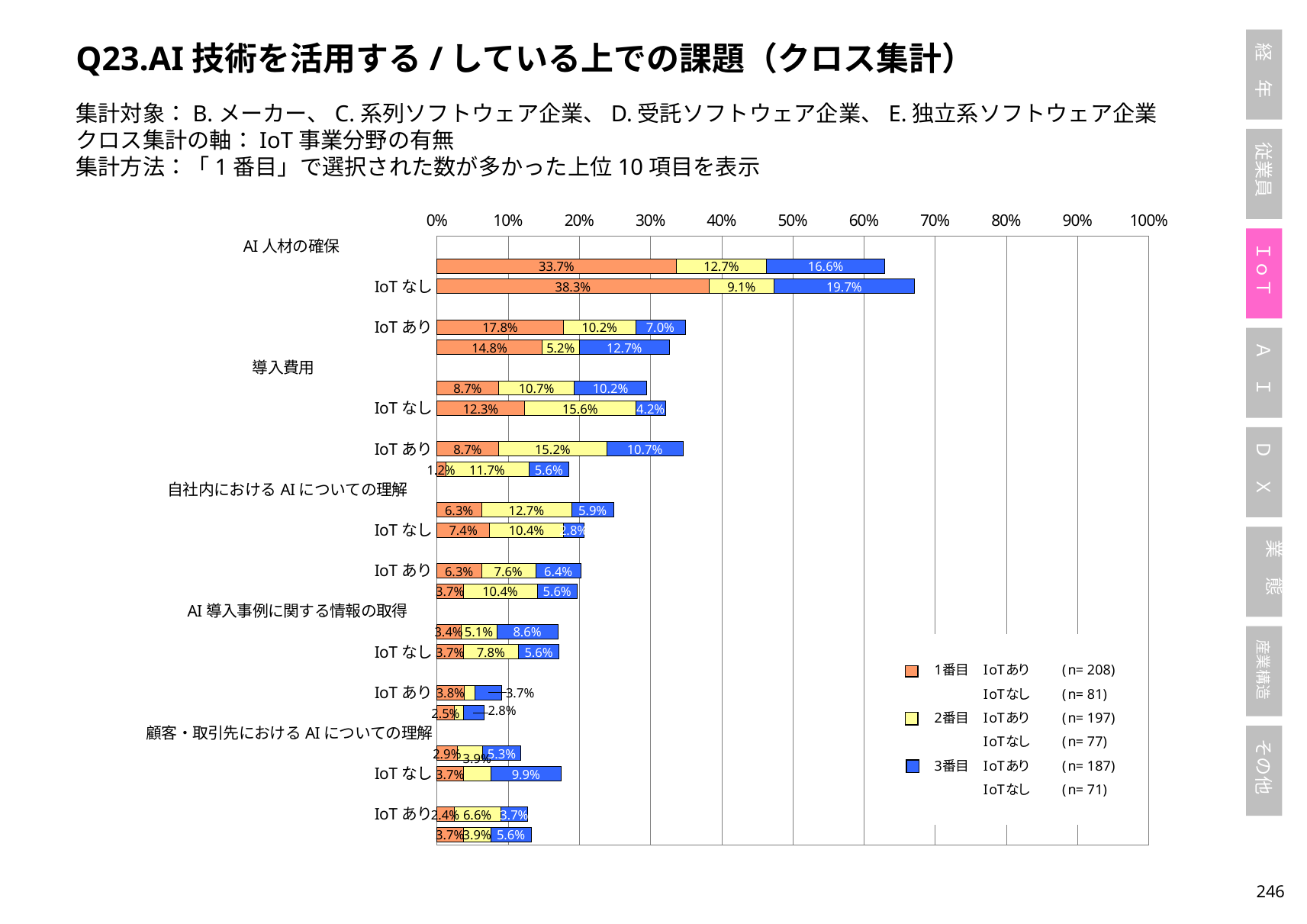
What is the total of the AI 人材の確保 IoT なし stacked bar (38.3%, 9.1%, 19.7%)? 67.1% According to the legend, what is the n for 1番目 IoTあり? n= 208 How many series does the legend list? 3 For AI 人材の確保, which bar has the larger 1番目 value, IoT あり or IoT なし? IoT なし For AI 人材の確保, what is the 2番目 value for the IoT なし bar? 9.1% For AI 人材の確保, what is the difference between the 1番目 values of IoT なし (38.3%) and IoT あり (33.7%)? 4.6% Is the total length of the AI 人材の確保 IoT なし bar greater or less than 60%? greater What are the three series named in the legend? 1番目, 2番目, 3番目 What kind of chart is shown on the slide? Stacked bar chart For AI 人材の確保, what is the 3番目 value for the IoT あり bar? 16.6% For AI 人材の確保, what is the 1番目 value for the IoT なし bar? 38.3% What is the total of the AI 人材の確保 IoT あり stacked bar (33.7%, 12.7%, 16.6%)? 63.0%